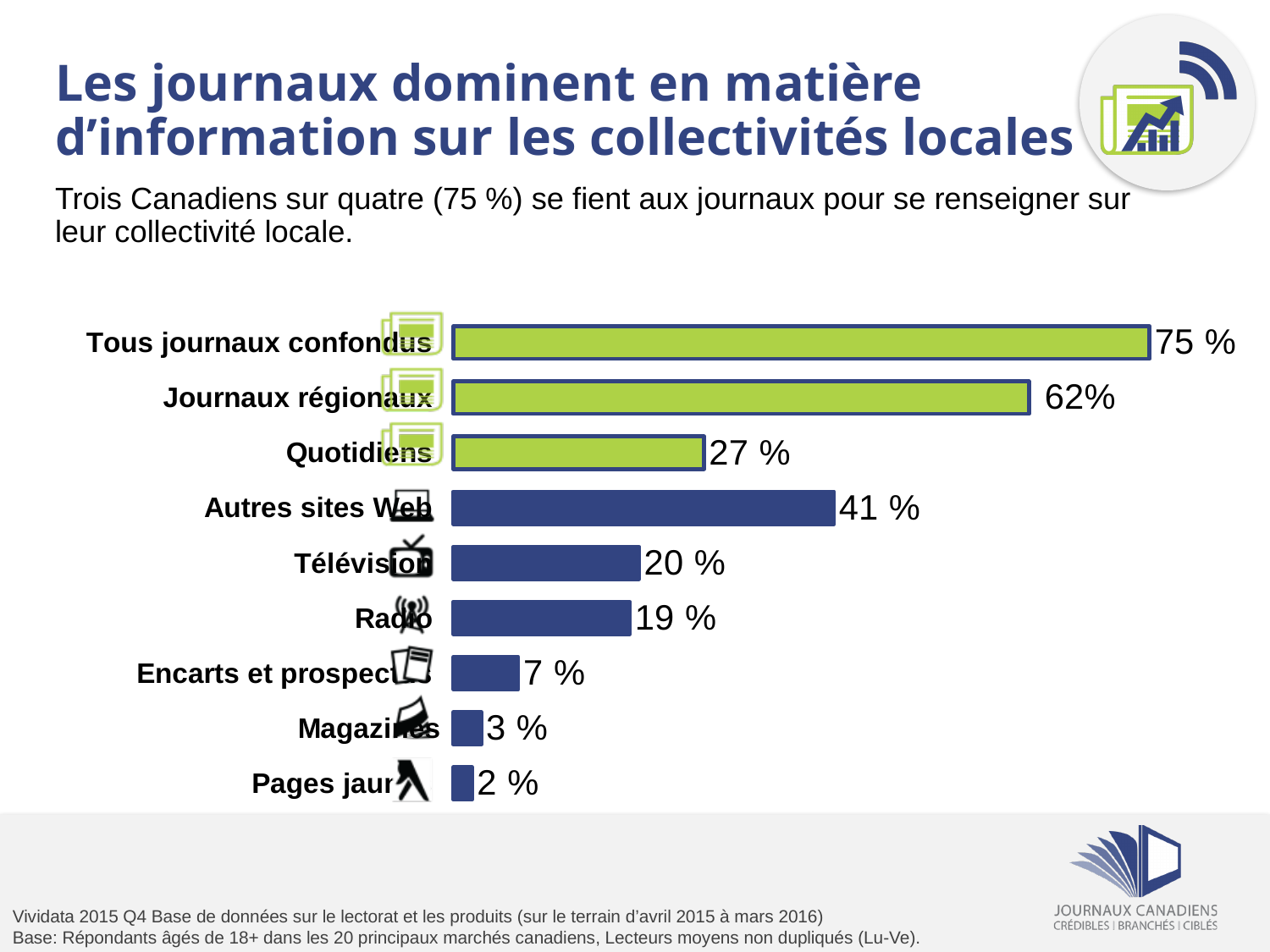
What is the value for Journaux régionaux? 62% What is the value for Quotidiens? 27 % What kind of chart is shown on the slide? bar chart How many categories are shown in the chart? 9 What is the value for Autres sites Web? 41 % What is the value for Radio? 19 % Which category has the highest value? Tous journaux confondus What is the value for Tous journaux confondus? 75 % Which is larger, the value for Autres sites Web or the value for Quotidiens? Autres sites Web What is the difference between the values for Journaux régionaux and Quotidiens? 35 % What is the difference between the values for Télévision and Radio? 1 % What is the value for Télévision? 20 %